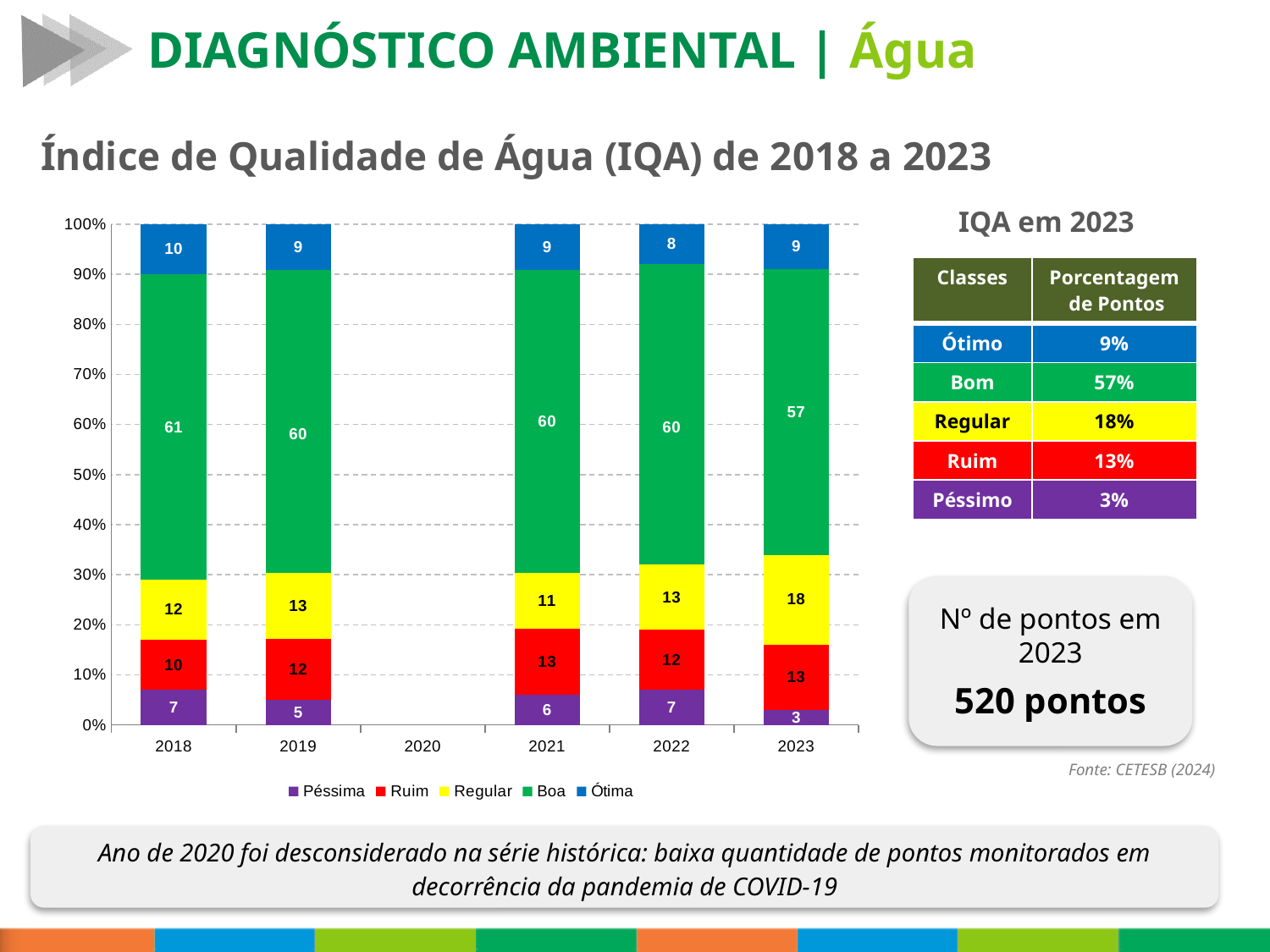
In which year is the Péssima value lowest? 2023 In which year is the Regular value highest? 2023 Which colour represents the Regular series in the chart? Yellow What kind of chart is shown? Stacked bar chart What is the value for Péssima in 2019? 5 What is the value for Ótima in 2022? 8 What is the value for Boa in 2023? 57 What is the difference between the Boa values for 2018 and 2023? 4 Which year on the x axis has no bar plotted? 2020 How many series does the legend list? 5 Which is larger, the Ruim value in 2021 or the Ruim value in 2018? 2021 What is the value for Regular in 2021? 11